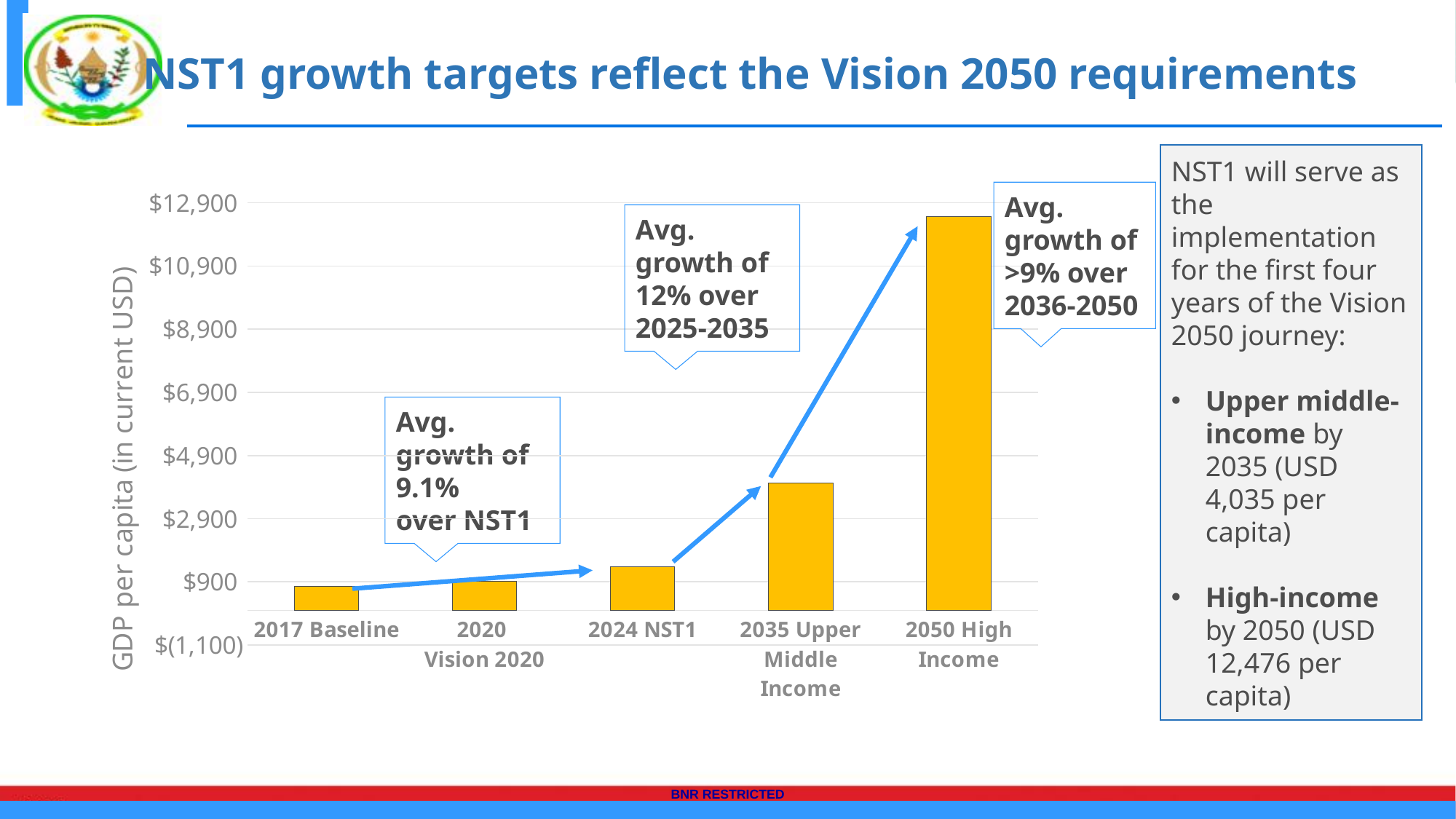
According to the callout on the chart, what average growth is shown for 2025-2035? 12% What is the label of the vertical axis of the chart? GDP per capita (in current USD) Which is larger, the value for 2035 Upper Middle Income or the value for 2024 NST1? 2035 Upper Middle Income How many categories (bars) are plotted in the chart? 5 Is the value for 2050 High Income greater or less than $10,900? greater Is the value for 2035 Upper Middle Income greater or less than $4,900? less Is the value for 2035 Upper Middle Income greater or less than $2,900? greater Which category has the lowest GDP per capita in the chart? 2017 Baseline What kind of chart is shown on the slide? Bar chart Do the GDP per capita values rise or fall from left to right along the x axis? Rise Which category has the highest GDP per capita in the chart? 2050 High Income